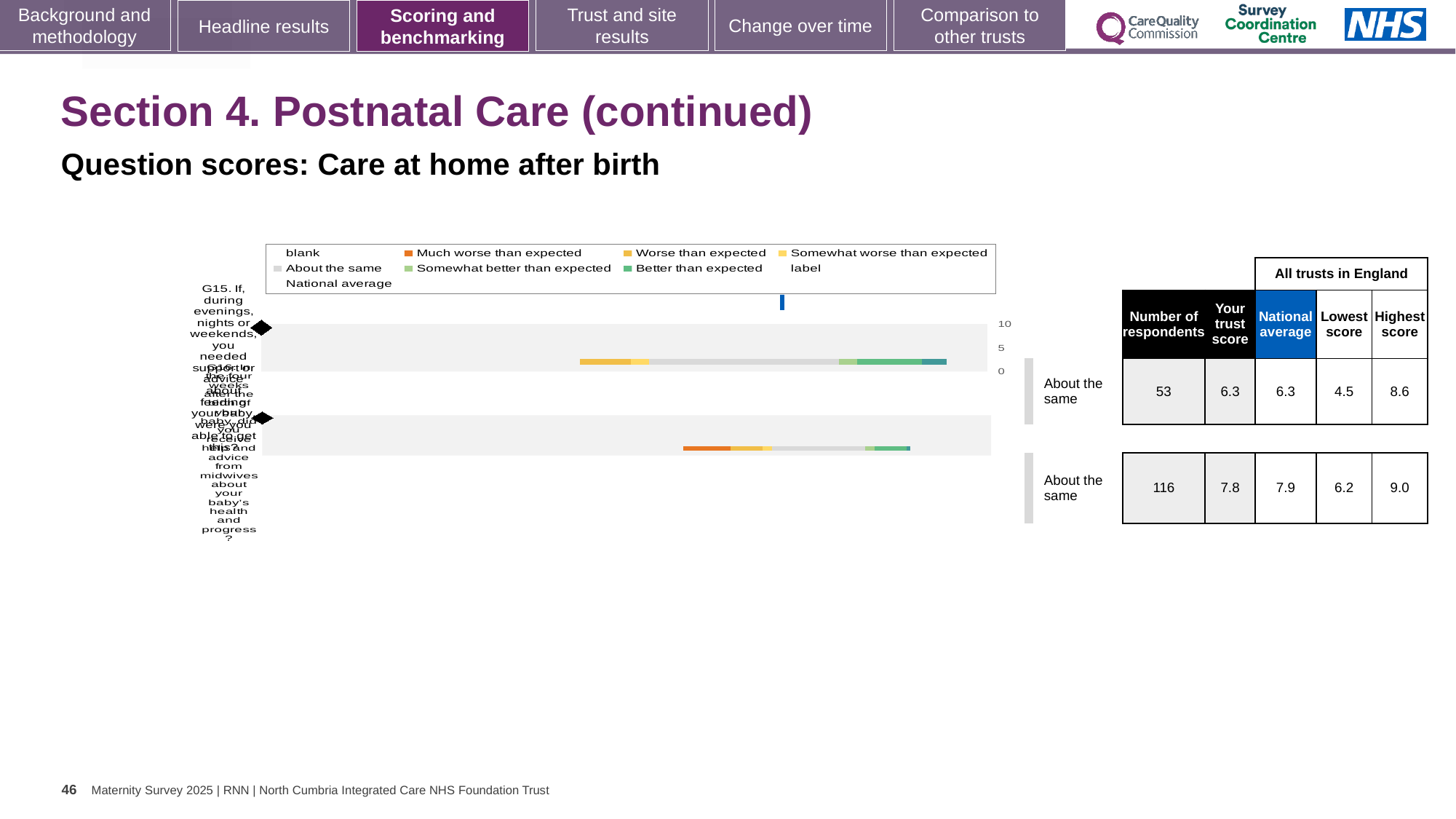
In the table next to the chart, what is the number of respondents for the first row? 53 What benchmark category is shown beside both bars in the chart? About the same In the table, what is the national average for the second row? 7.9 What is the difference between the highest score and the lowest score for the first row of the table? 4.1 What kind of chart is shown on the slide? bar chart In the table, what is the highest score among all trusts in England for the first row? 8.6 How many question bars are plotted in the chart? 2 In the table, what is 'Your trust score' for the second row? 7.8 In the table, what is the lowest score among all trusts in England for the second row? 6.2 In the table, what is 'Your trust score' for the first row? 6.3 In the table next to the chart, what is the number of respondents for the second row? 116 Which row of the table has the larger number of respondents, the first or the second? the second